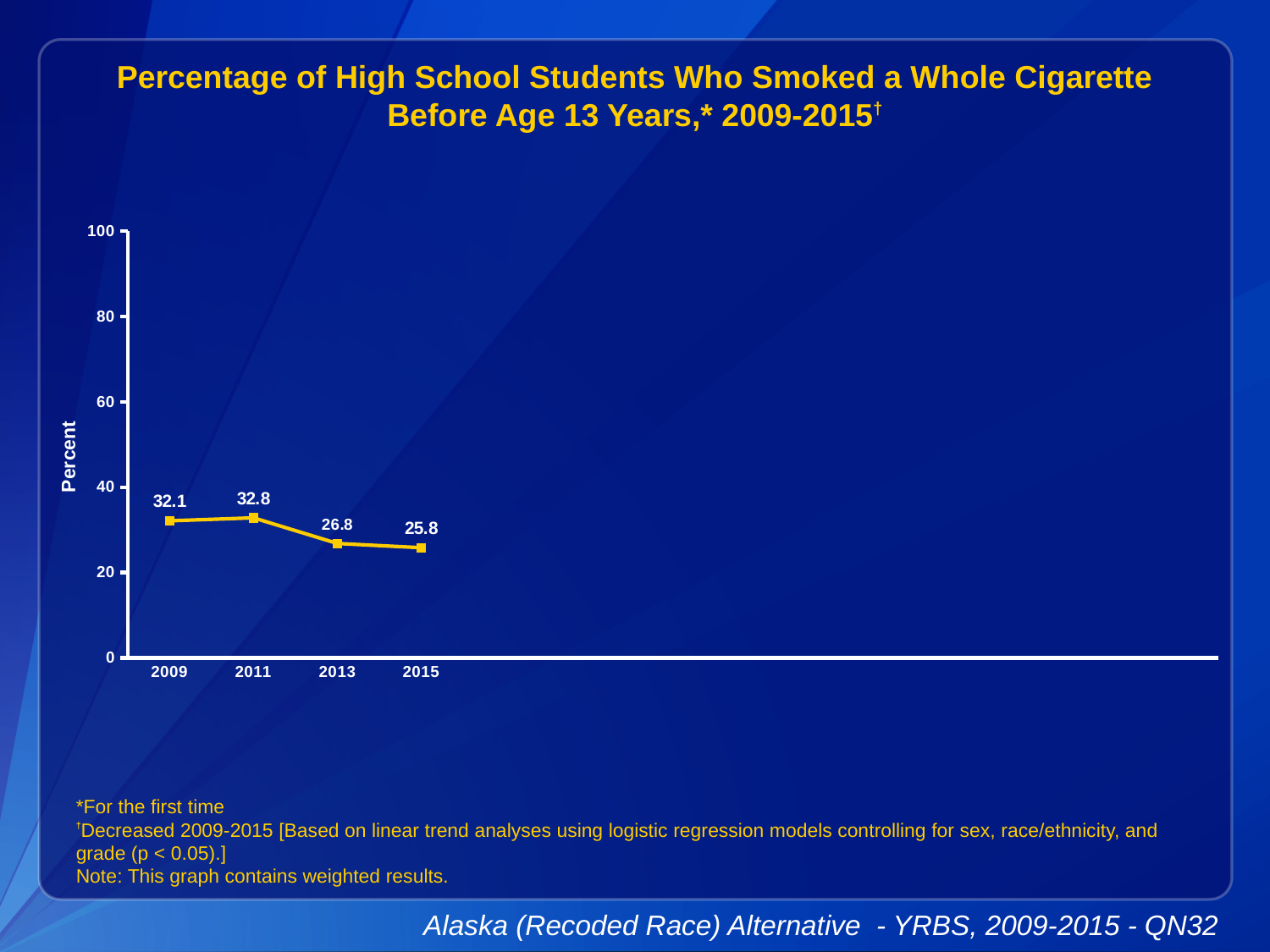
Which is larger, the value for 2009 or the value for 2013? 2009 Which year has the highest value? 2011 What is the value for 2011? 32.8 What is the difference between the values for 2011 and 2015? 7.0 What is the value for 2013? 26.8 What is the value for 2015? 25.8 What kind of chart is shown? line chart Is the value for 2013 greater or less than 40? less How many years are plotted on the chart? 4 Which year has the lowest value? 2015 What is the value for 2009? 32.1 Do the values generally rise or fall from 2009 to 2015? fall